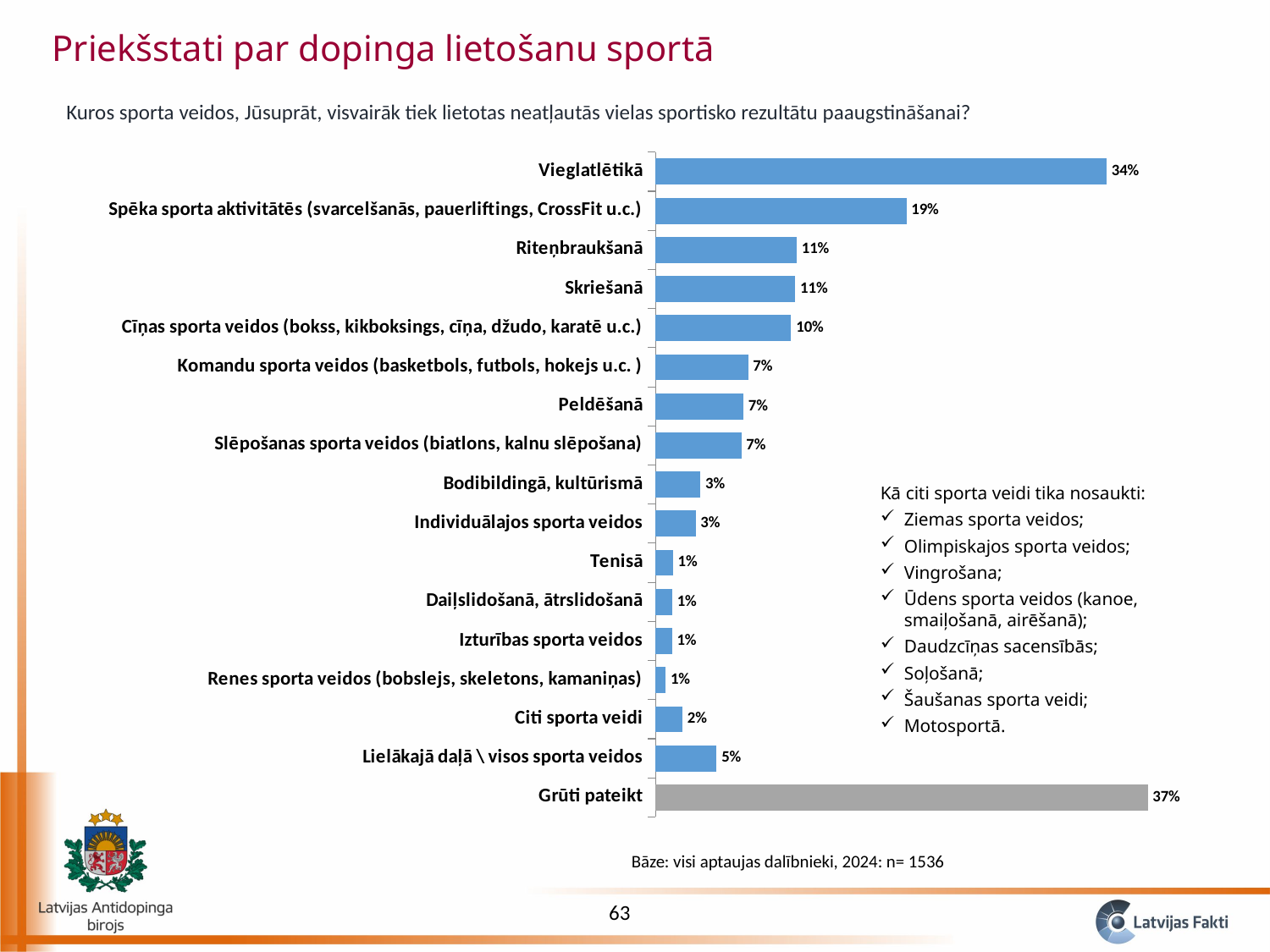
What is the difference between the values for Vieglatlētikā and Spēka sporta aktivitātēs? 15% What is the difference between the values for Grūti pateikt and Vieglatlētikā? 3% What is the value for Lielākajā daļā \ visos sporta veidos? 5% Which bar is shown in a different colour (grey) from the others? Grūti pateikt Which named sport category has the highest value? Vieglatlētikā How many categories (bars) are shown in the chart? 17 Which category has the highest value in the chart? Grūti pateikt What is the value for Vieglatlētikā? 34% What is the value for Spēka sporta aktivitātēs (svarcelšanās, pauerliftings, CrossFit u.c.)? 19% What is the value for Grūti pateikt? 37% What kind of chart is shown on the slide? bar chart Which is larger, the value for Cīņas sporta veidos or the value for Peldēšanā? Cīņas sporta veidos